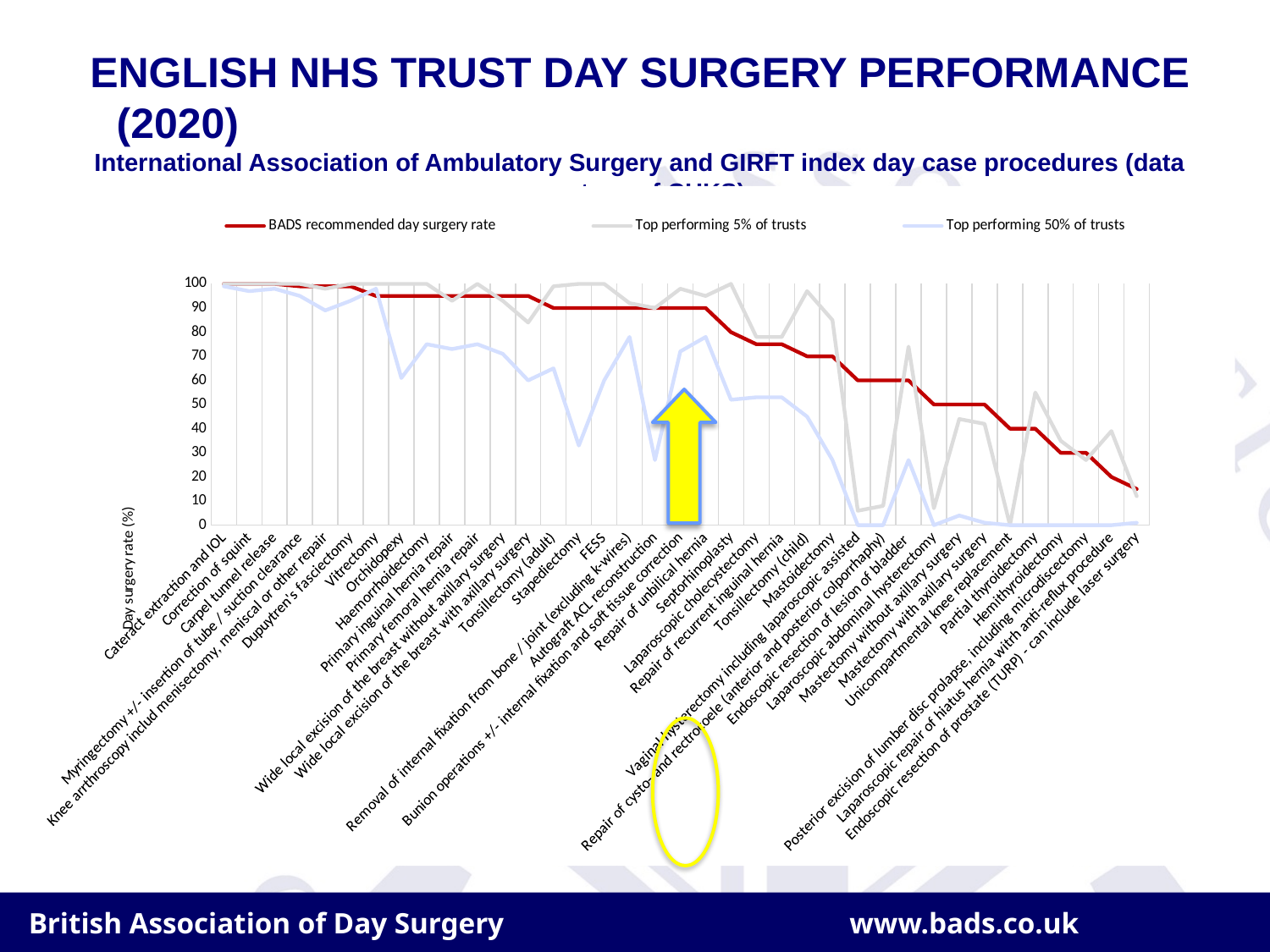
Is the BADS recommended day surgery rate for Endoscopic resection of prostate (TURP) greater or less than 30? less Which has the higher BADS recommended day surgery rate: Cataract extraction and IOL or Endoscopic resection of prostate (TURP)? Cataract extraction and IOL Is the BADS recommended day surgery rate for Repair of umbilical hernia greater or less than 80? greater Which series is drawn in red? BADS recommended day surgery rate Is the BADS recommended day surgery rate for Cataract extraction and IOL greater or less than 90? greater What kind of chart is shown on the slide? line chart What is the label on the vertical axis? Day surgery rate (%) For which procedure is the BADS recommended day surgery rate lowest? Endoscopic resection of prostate (TURP) - can include laser surgery How many series does the legend list? 3 Does the BADS recommended day surgery rate rise or fall moving from left to right along the x axis? fall